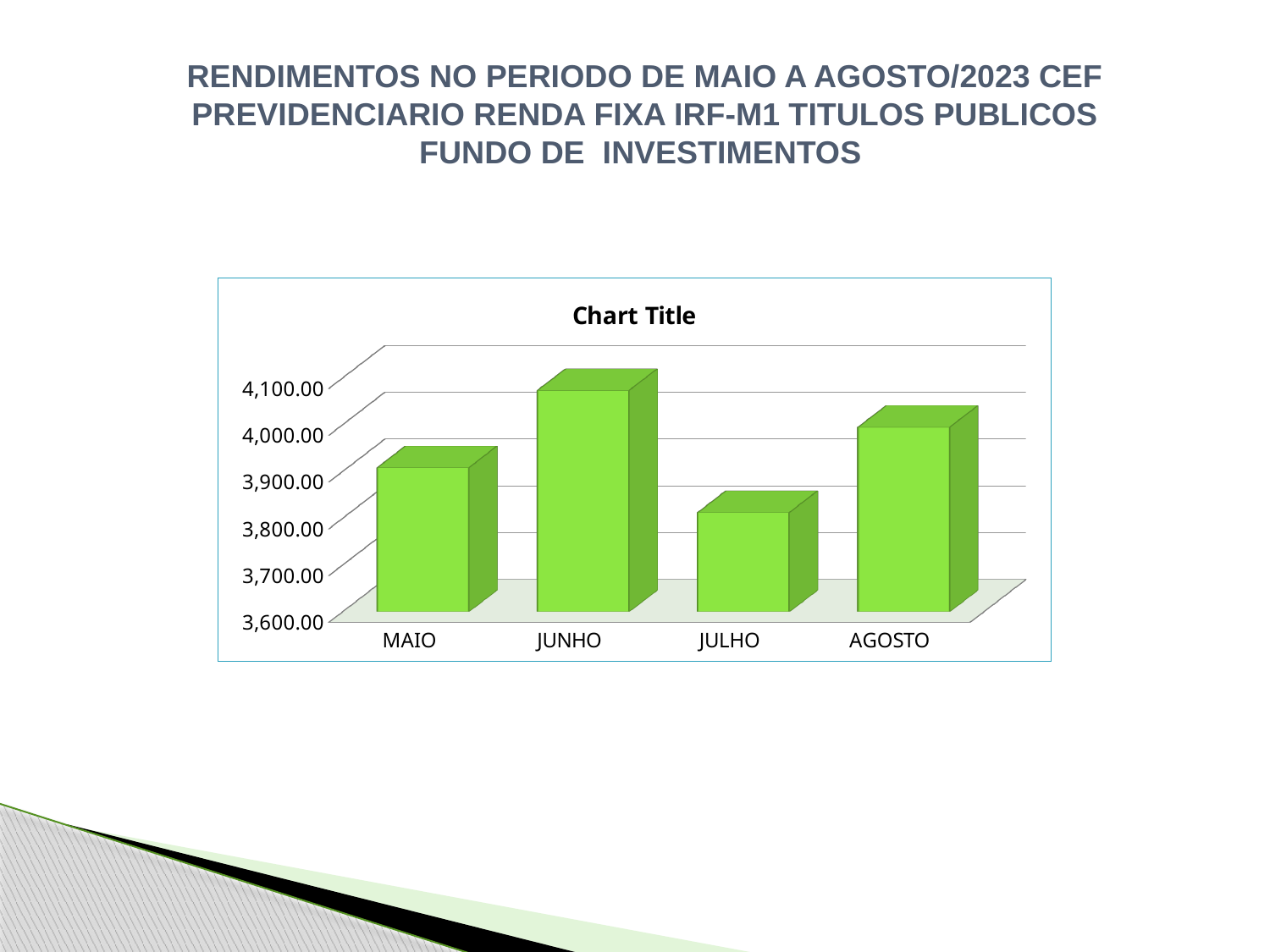
Which month has the highest bar in the chart? JUNHO Which month has the lowest bar in the chart? JULHO Is the value for MAIO greater or less than 4,000.00? less Which is larger, the value for JUNHO or the value for JULHO? JUNHO What title is printed above the plot area of the chart? Chart Title What kind of chart is shown on the slide? bar chart Does the value rise or fall from JUNHO to JULHO? fall Is the value for JUNHO greater or less than 4,000.00? greater Is the value for JULHO greater or less than 3,700.00? greater How many categories are plotted on the x axis of the chart? 4